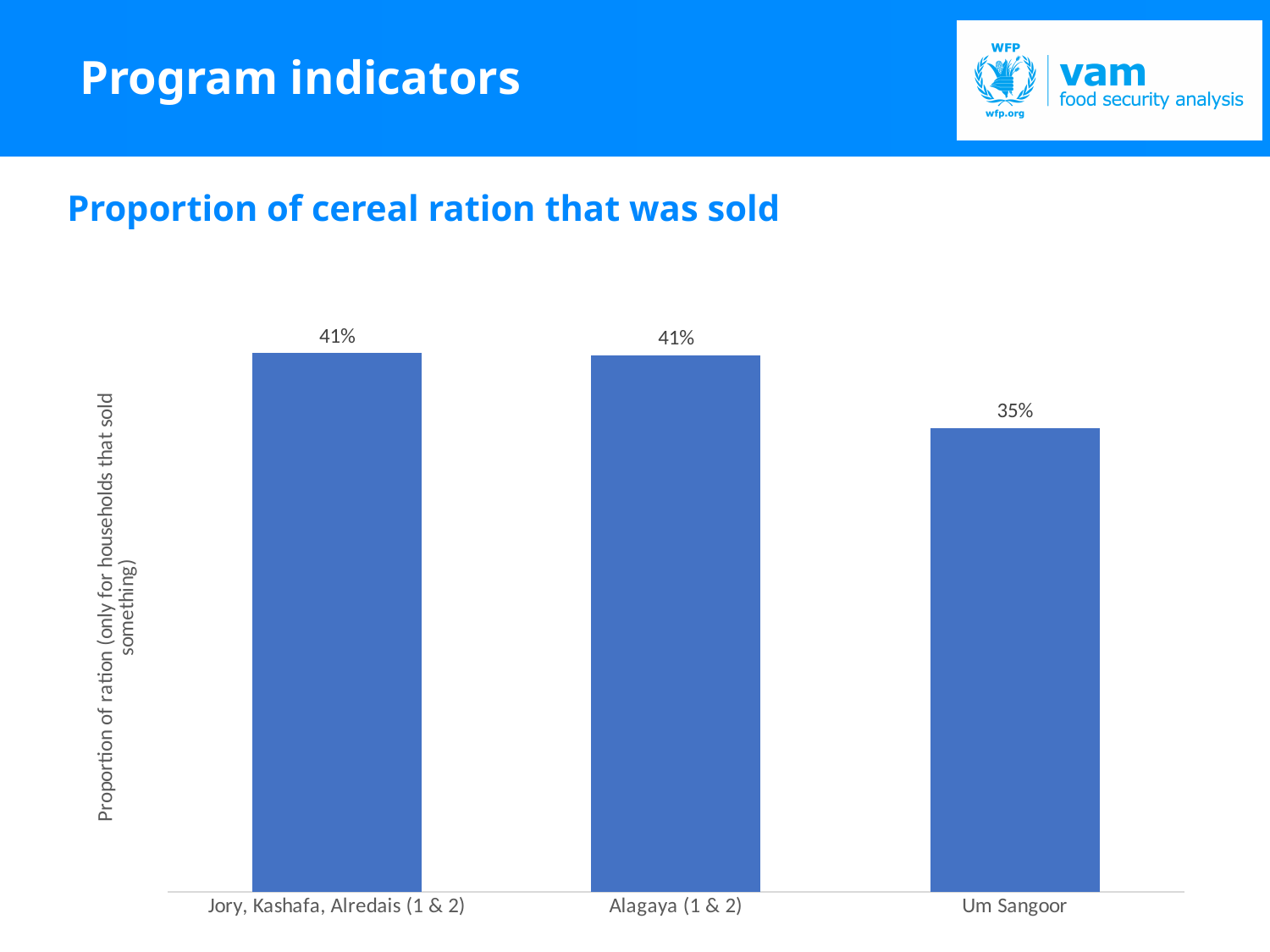
What kind of chart is shown on the slide? Bar chart How many categories are shown on the x axis of the chart? 3 What is the proportion of cereal ration sold for Jory, Kashafa, Alredais (1 & 2)? 41% What is the proportion of cereal ration sold for Um Sangoor? 35% What is the title of the chart? Proportion of cereal ration that was sold What is the difference between the value for Alagaya (1 & 2) and the value for Um Sangoor? 6% What is the proportion of cereal ration sold for Alagaya (1 & 2)? 41% What is the label of the vertical axis? Proportion of ration (only for households that sold something) Which is larger, the value for Jory, Kashafa, Alredais (1 & 2) or the value for Um Sangoor? Jory, Kashafa, Alredais (1 & 2) Which category has the lowest proportion of cereal ration sold? Um Sangoor Do the values rise or fall from left to right across the categories? Fall